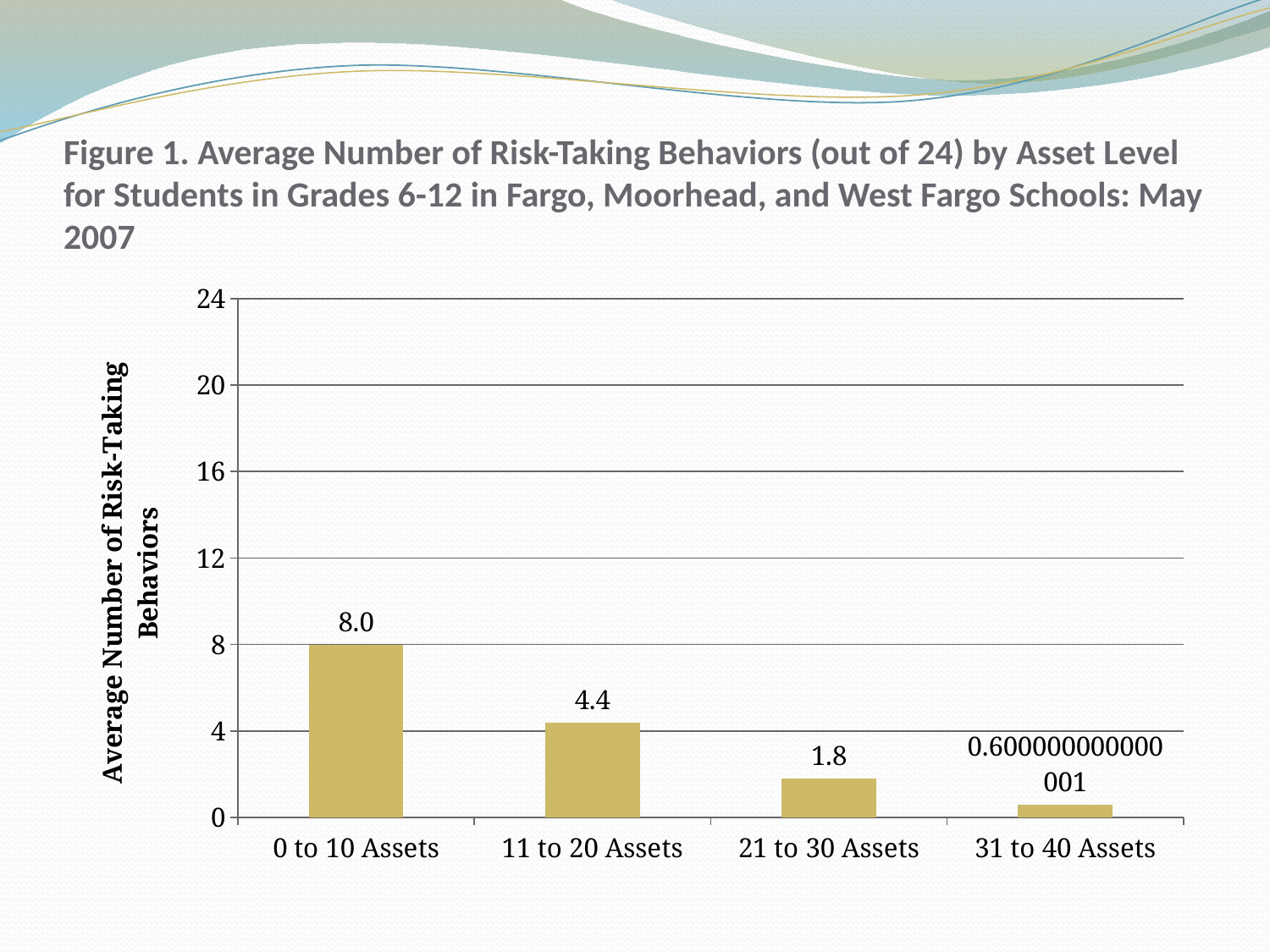
What is the difference between the average number of risk-taking behaviors for 11 to 20 Assets and 21 to 30 Assets? 2.6 Is the value for 31 to 40 Assets greater or less than 4? less Which asset level has the lowest average number of risk-taking behaviors? 31 to 40 Assets How many asset level categories are shown on the x axis? 4 Which has a larger average number of risk-taking behaviors, 11 to 20 Assets or 21 to 30 Assets? 11 to 20 Assets What is the average number of risk-taking behaviors for students with 21 to 30 Assets? 1.8 What is the average number of risk-taking behaviors for students with 11 to 20 Assets? 4.4 What is the difference between the average number of risk-taking behaviors for 0 to 10 Assets and 11 to 20 Assets? 3.6 Do the values rise or fall as the asset level increases along the x axis? Fall Which asset level has the highest average number of risk-taking behaviors? 0 to 10 Assets What is the average number of risk-taking behaviors for students with 0 to 10 Assets? 8.0 What kind of chart is shown on the slide? Bar chart